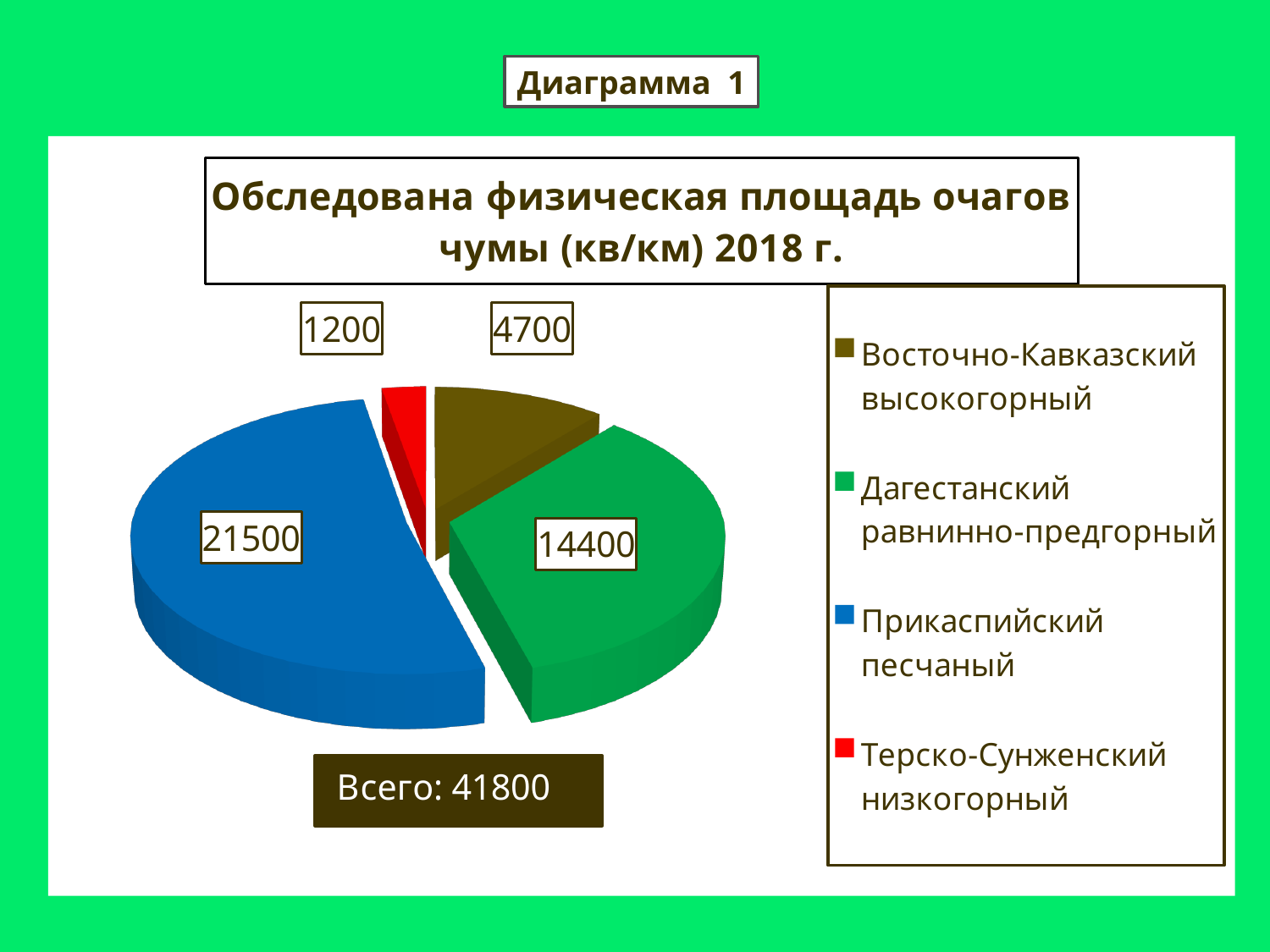
What is the difference between the values for Прикаспийский песчаный and Дагестанский равнинно-предгорный? 7100 What type of chart is shown on the slide? Pie chart Which category has the smallest slice of the pie? Терско-Сунженский низкогорный What total is shown below the pie chart? Всего: 41800 What is the value for Восточно-Кавказский высокогорный? 4700 Which is larger: the value for Восточно-Кавказский высокогорный or Терско-Сунженский низкогорный? Восточно-Кавказский высокогорный What colour is the slice for Прикаспийский песчаный? Blue Which category has the largest slice of the pie? Прикаспийский песчаный What is the value for Терско-Сунженский низкогорный? 1200 What is the value for Дагестанский равнинно-предгорный? 14400 What is the value for Прикаспийский песчаный? 21500 How many categories does the pie chart show? 4